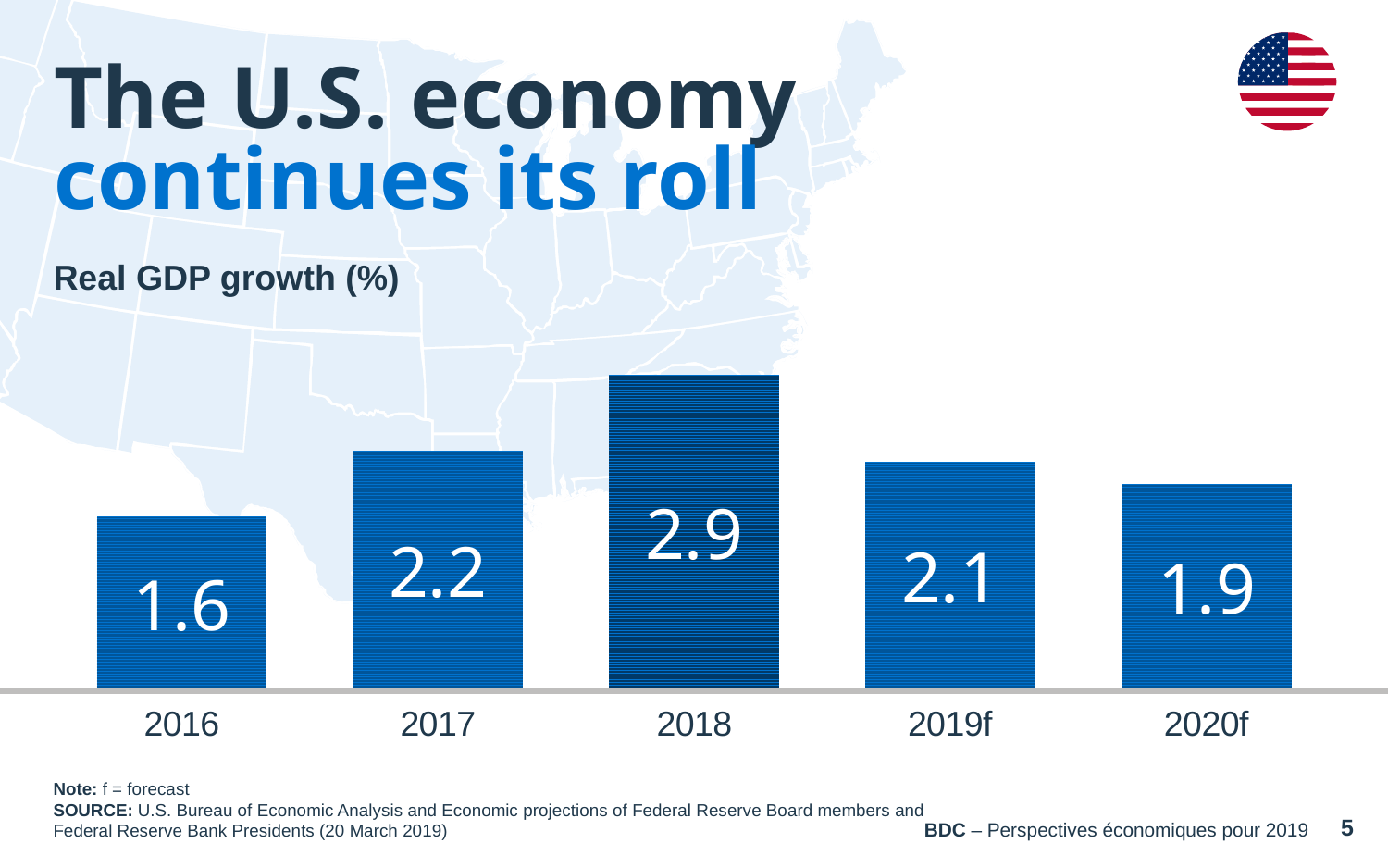
What does the 'f' suffix on 2019f and 2020f stand for, according to the note? forecast What is the difference between the real GDP growth values for 2019f and 2020f? 0.2 What is the real GDP growth value for 2016? 1.6 How many years are shown on the chart? 5 What is the real GDP growth value for 2018? 2.9 What is the forecast real GDP growth value for 2020f? 1.9 Which year has the highest real GDP growth? 2018 Which year has the lowest real GDP growth? 2016 Do the values rise or fall from 2018 to 2020f? fall What is the difference between the real GDP growth values for 2018 and 2017? 0.7 What kind of chart is shown on the slide? bar chart Which is larger, the real GDP growth value for 2017 or for 2019f? 2017